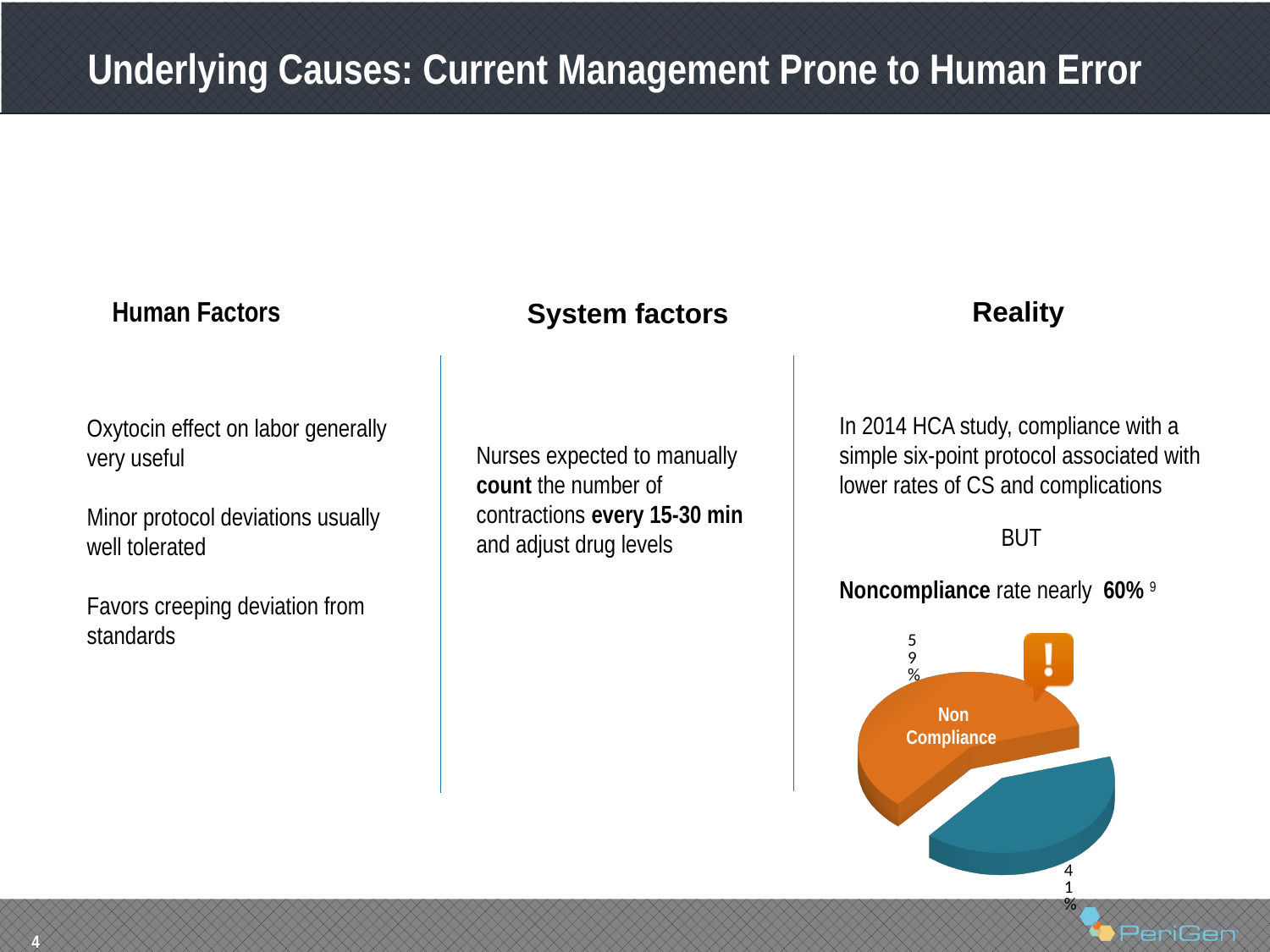
How many slices does the pie chart have? 2 What percentage is shown for the blue slice of the pie chart? 41% What is the difference in percentage points between the Non Compliance slice and the blue slice? 18 What percentage of the pie chart is labelled Non Compliance? 59% Is the value for the Non Compliance slice greater or less than 50%? greater What share of the pie does the Non Compliance slice represent? 59% Is the Non Compliance slice larger or smaller than the blue slice? larger What colour is the Non Compliance slice in the pie chart? orange What type of chart is shown on the slide? pie chart Which slice of the pie chart is the largest? Non Compliance